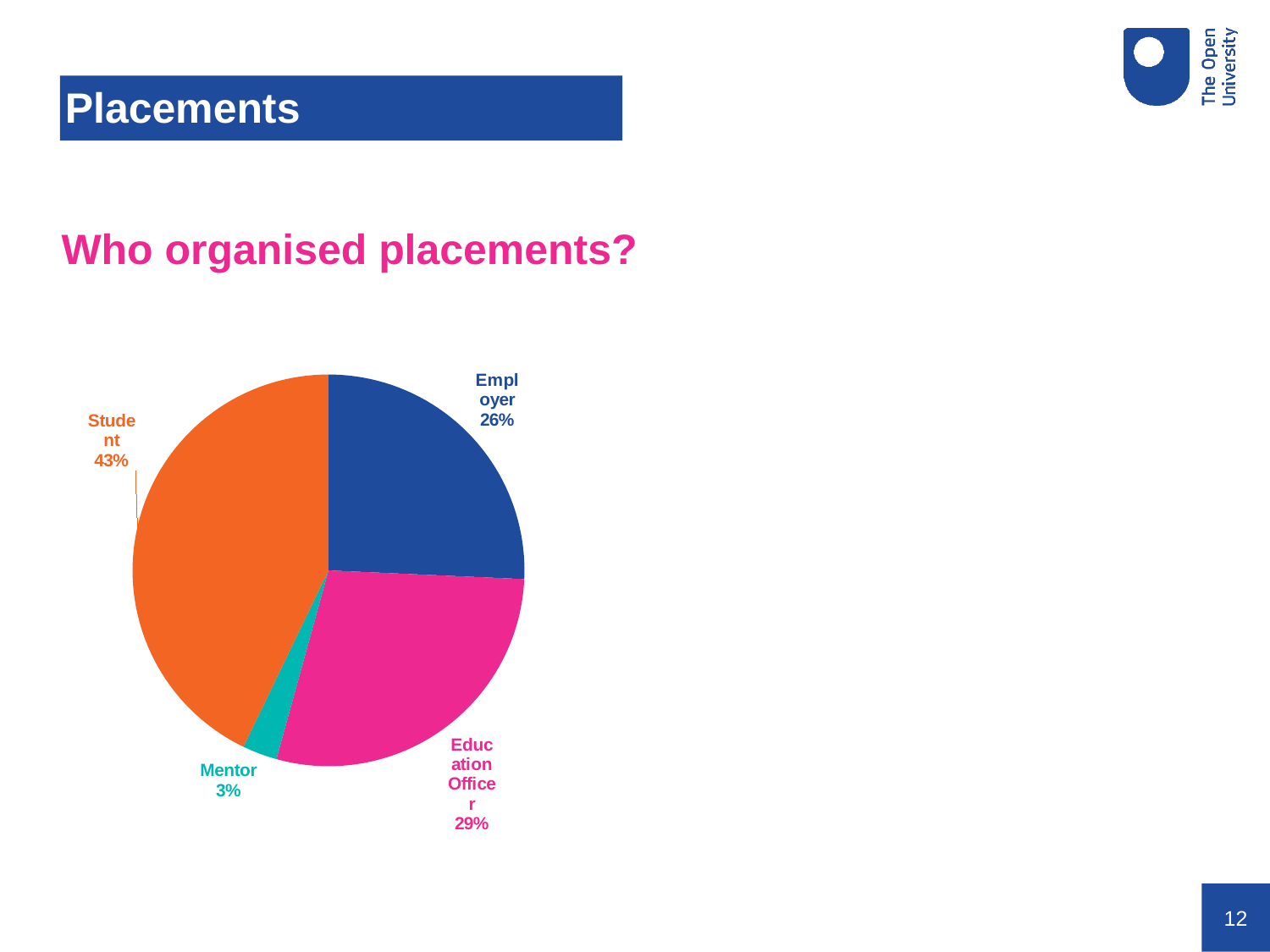
What is the difference in percentage points between the Student and Employer shares? 17 What percentage of placements were organised by the Employer? 26% What kind of chart is shown on the slide? pie chart What colour is the Student slice of the pie? orange Which category has the largest share of the pie? Student What percentage of placements were organised by a Mentor? 3% Which category has the smallest share of the pie? Mentor How many slices does the pie chart have? 4 Which is larger, the Education Officer share or the Employer share? Education Officer What percentage of placements were organised by the Student? 43% What is the difference in percentage points between the Education Officer and Mentor shares? 26 What percentage of placements were organised by the Education Officer? 29%